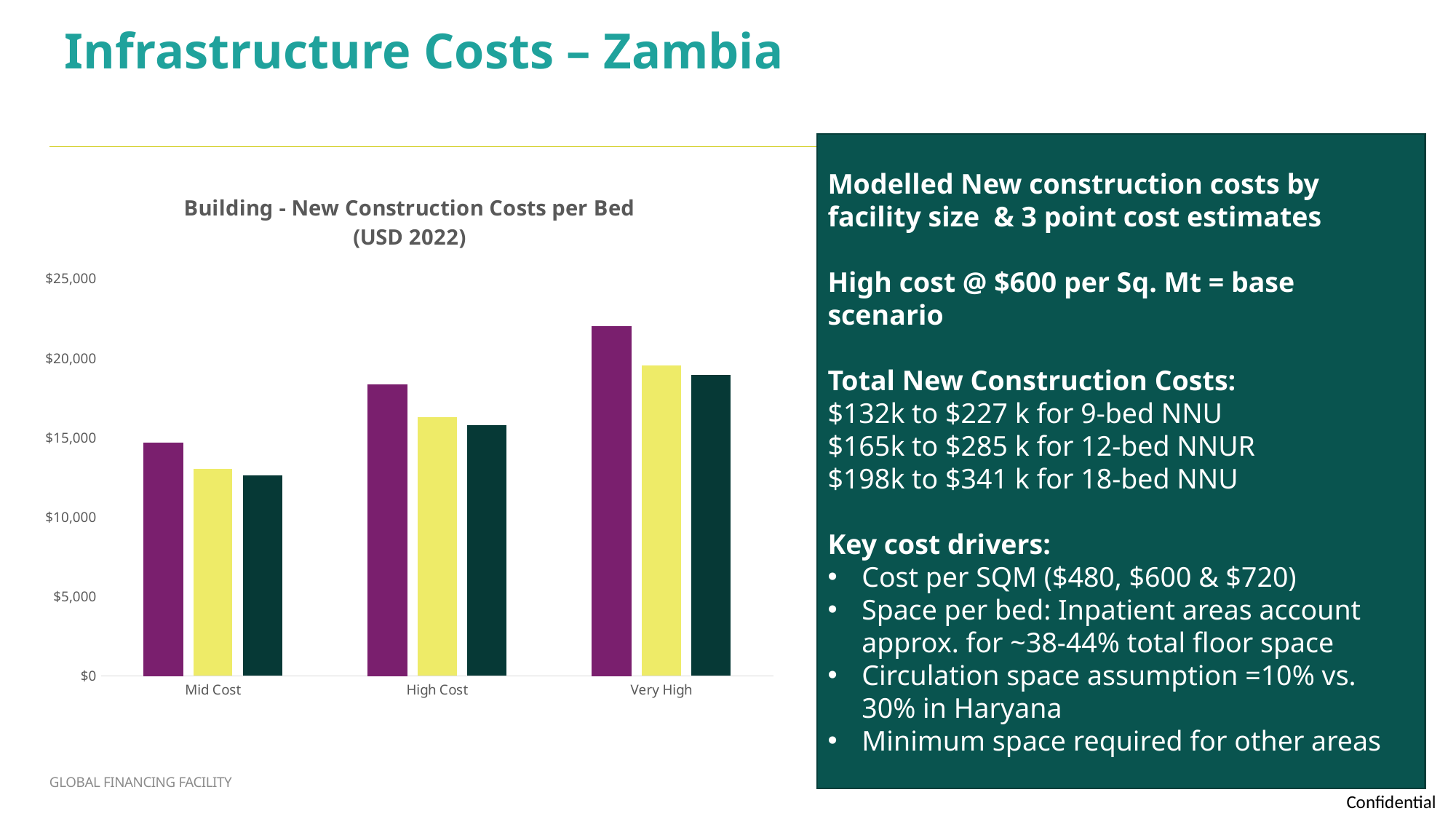
Is the value of the purple bar for Very High greater or less than $20,000? greater What is the title of the chart? Building - New Construction Costs per Bed (USD 2022) How many categories are shown on the x axis of the chart? 3 In the Very High category, which is larger: the purple bar or the yellow bar? the purple bar What kind of chart is shown on the slide? bar chart Which category has the shortest dark green bar? Mid Cost Is the value of the purple bar for High Cost greater or less than $15,000? greater Is the value of the dark green bar for Very High greater or less than $20,000? less Which category has the tallest purple bar? Very High How many bars are plotted for each category in the chart? 3 Do the bar values rise or fall moving from Mid Cost to Very High along the x axis? rise